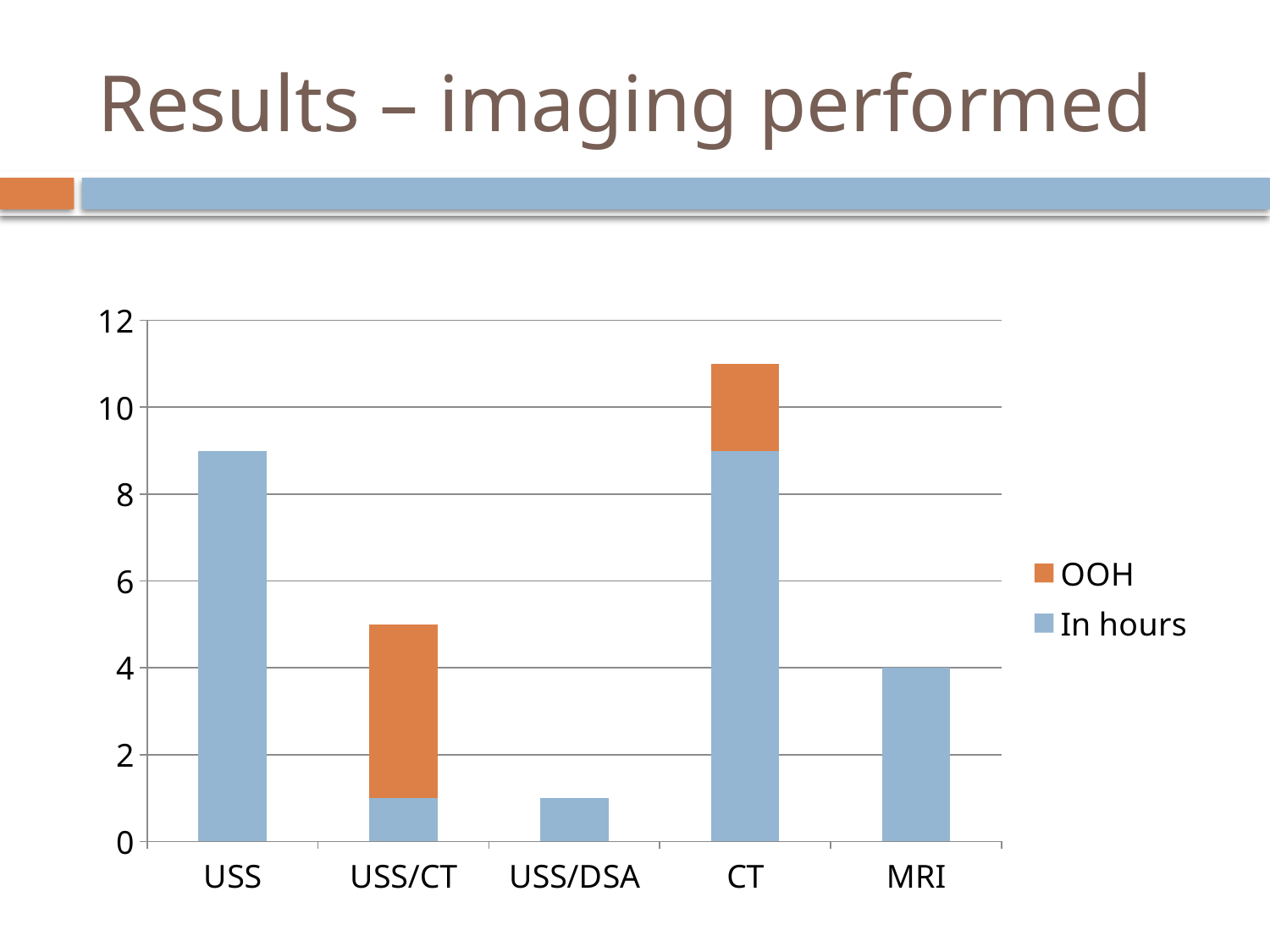
Which is larger, the total bar for USS/CT or the total bar for MRI? USS/CT What kind of chart is shown on the slide? bar chart Is the In hours value for USS greater or less than 8? greater What is the title of the slide containing the chart? Results – imaging performed Is the In hours value for USS/DSA greater or less than 2? less How many series does the chart legend list? 2 Which categories have an OOH segment in their bar? USS/CT and CT Which category has the shortest bar overall? USS/DSA Which category has the tallest bar overall? CT Is the total value for CT greater or less than 10? greater How many categories are shown on the x axis of the chart? 5 What is the In hours value for MRI? 4